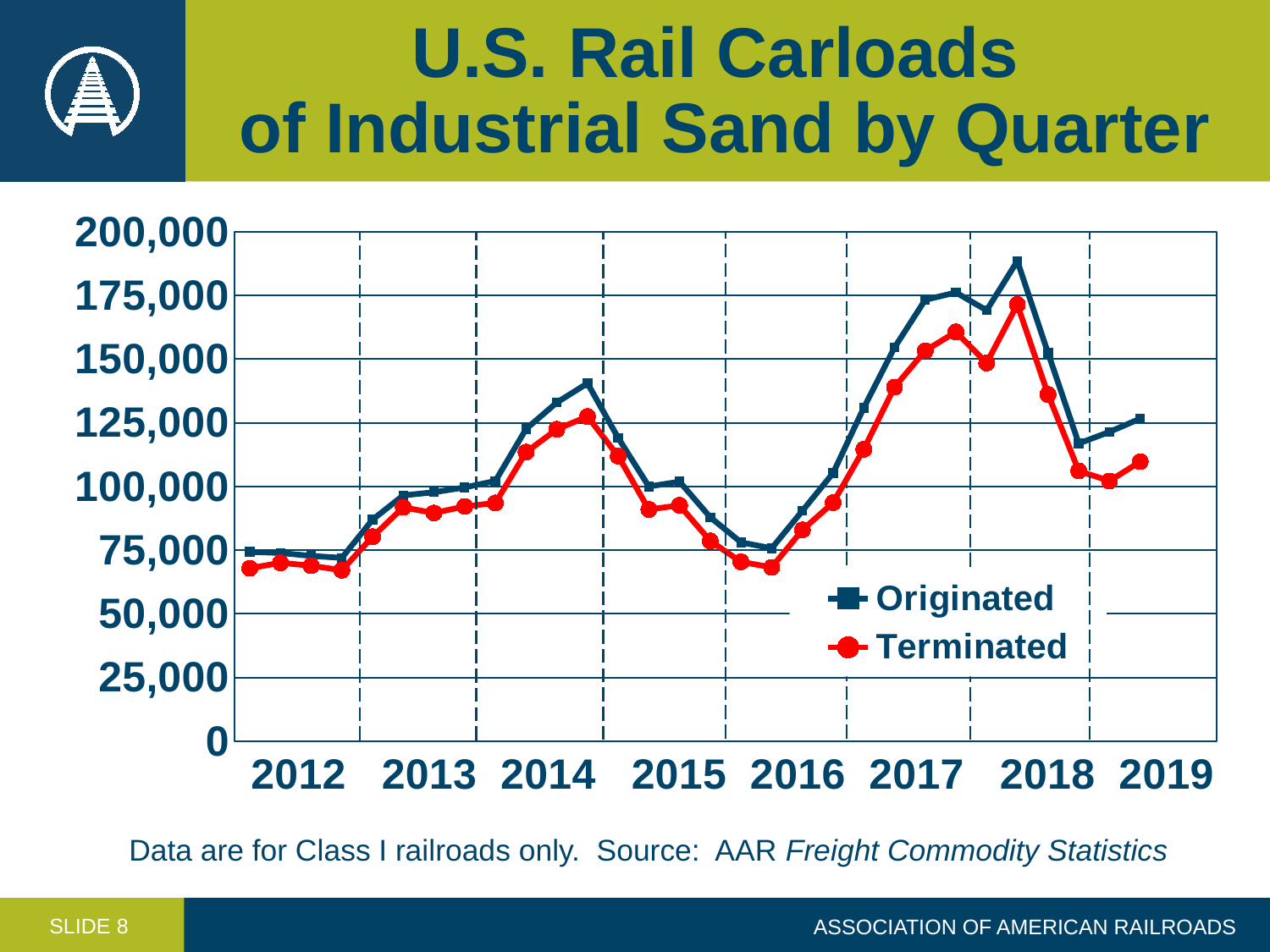
Do the values rise or fall from the 2014 peak to 2016? Fall What are the two series named in the legend? Originated and Terminated Which series is generally higher across the chart, Originated or Terminated? Originated How many years are labelled on the x axis? 8 In which year does the Originated series reach its highest value? 2018 How many series does the legend list? 2 Is the highest value of the Originated series greater or less than 175,000? greater Which colour is used for the Terminated series? Red Is the Originated peak in 2014 greater or less than 150,000? less What kind of chart is shown on the slide? Line chart Is the highest value of the Terminated series greater or less than 150,000? greater